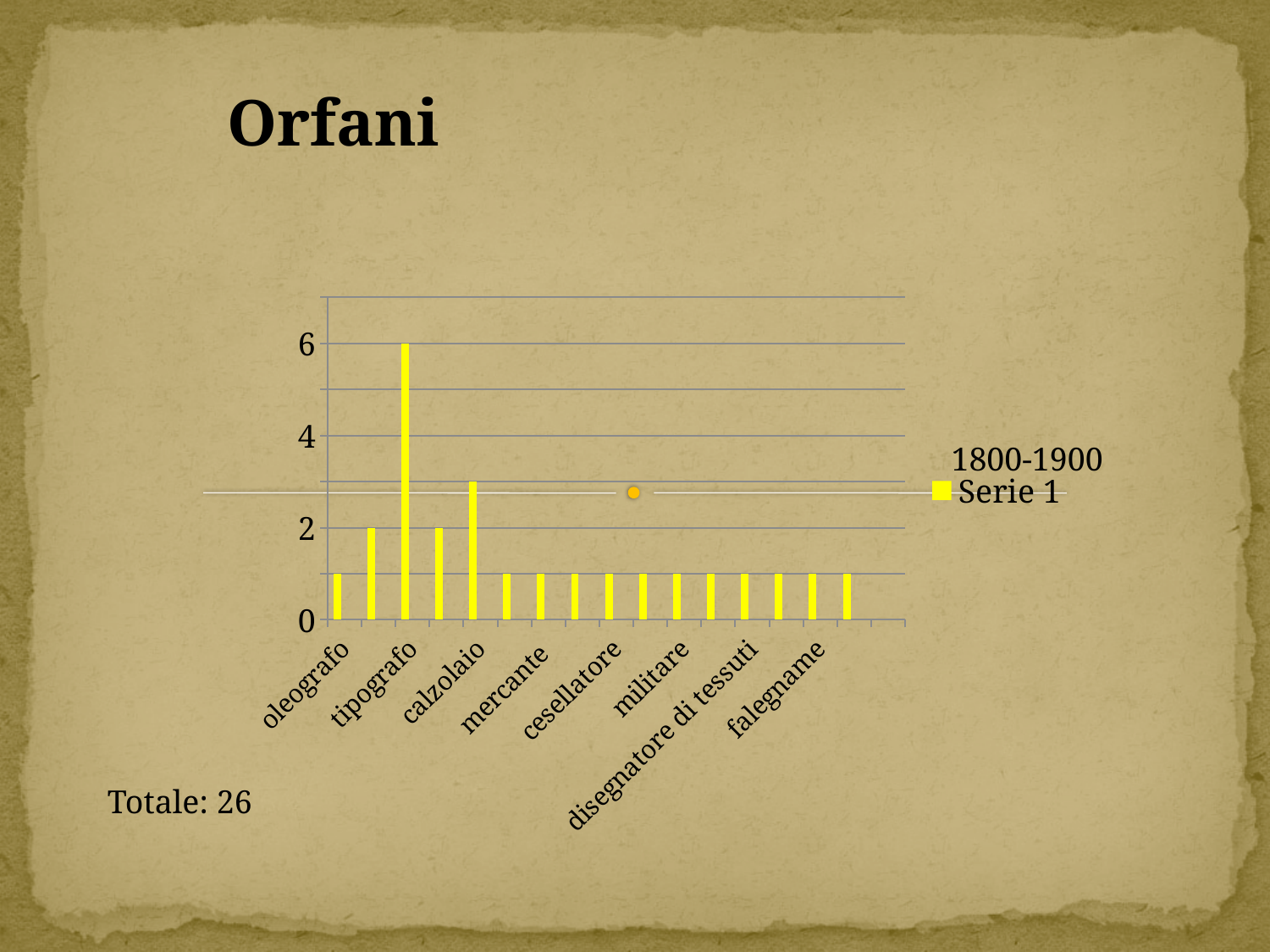
How many series does the legend list? 1 What is the value for tipografo? 6 Which is larger, the value for tipografo or the value for calzolaio? tipografo Is the value for calzolaio greater or less than 4? less Is the value for mercante greater or less than 2? less Which is larger, the value for calzolaio or the value for falegname? calzolaio Is the value for oleografo greater or less than 2? less What type of chart is shown on the slide? bar chart Which category has the highest value? tipografo What is the title of the chart? Orfani How many bars are plotted in the chart? 16